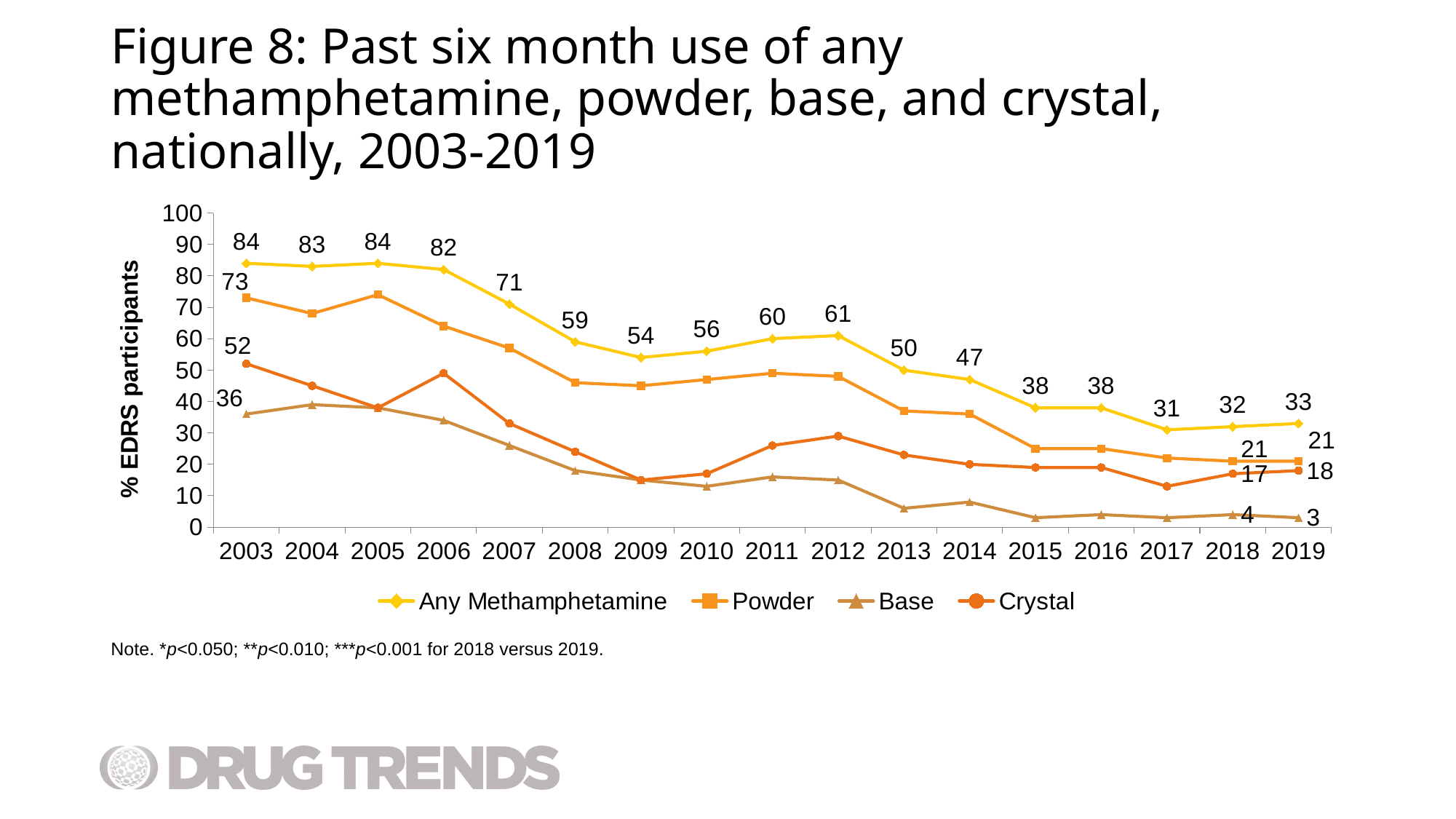
What kind of chart is shown on the slide? line chart What is the value for Any Methamphetamine in 2003? 84 In which year is the Any Methamphetamine value lowest? 2017 How many years are shown on the x axis? 17 How many series does the legend list? 4 Is the value for Base in 2009 greater or less than 20? less Is the value for Powder in 2010 greater or less than 40? greater What is the value for Crystal in 2019? 18 In 2019, which is larger: the Powder value or the Crystal value? Powder What is the difference between the Any Methamphetamine values in 2003 and 2019? 51 What is the value for Powder in 2003? 73 What is the value for Base in 2018? 4